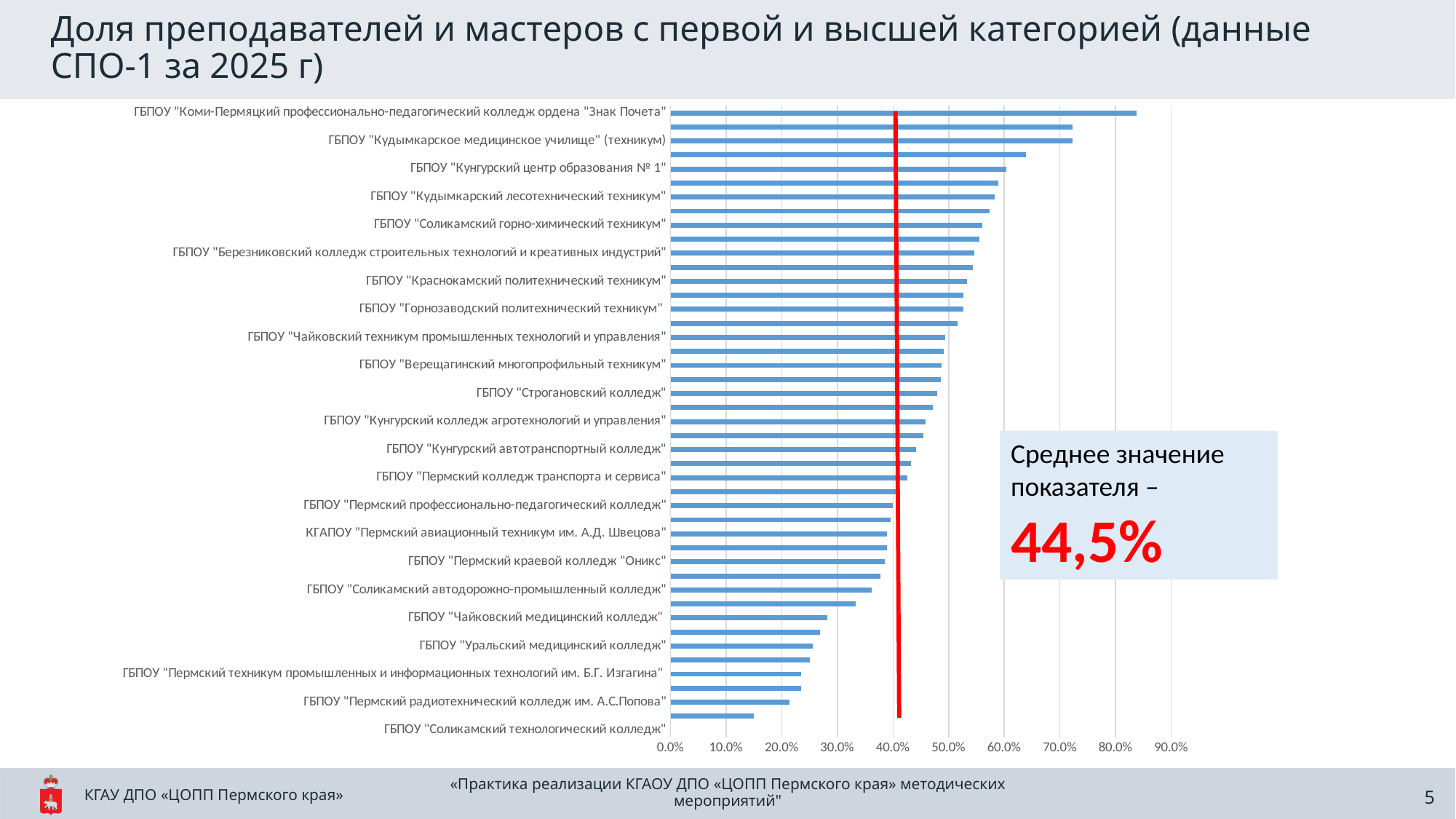
Is the value for ГБПОУ "Коми-Пермяцкий профессионально-педагогический колледж ордена "Знак Почета" greater or less than 80.0%? greater Is the value for ГБПОУ "Чайковский медицинский колледж" greater or less than 30.0%? less What is the highest tick value shown on the horizontal axis? 90.0% Is the value for ГБПОУ "Кудымкарское медицинское училище" (техникум) greater or less than 70.0%? greater What kind of chart is shown on the slide? bar chart Which institution has the highest share of teachers and masters with first and highest category? ГБПОУ "Коми-Пермяцкий профессионально-педагогический колледж ордена "Знак Почета" Which has a larger value: ГБПОУ "Строгановский колледж" or ГБПОУ "Уральский медицинский колледж"? ГБПОУ "Строгановский колледж" Which institution has the lowest share on the chart? ГБПОУ "Соликамский технологический колледж" What average value of the indicator is stated in the text box on the slide? 44,5%